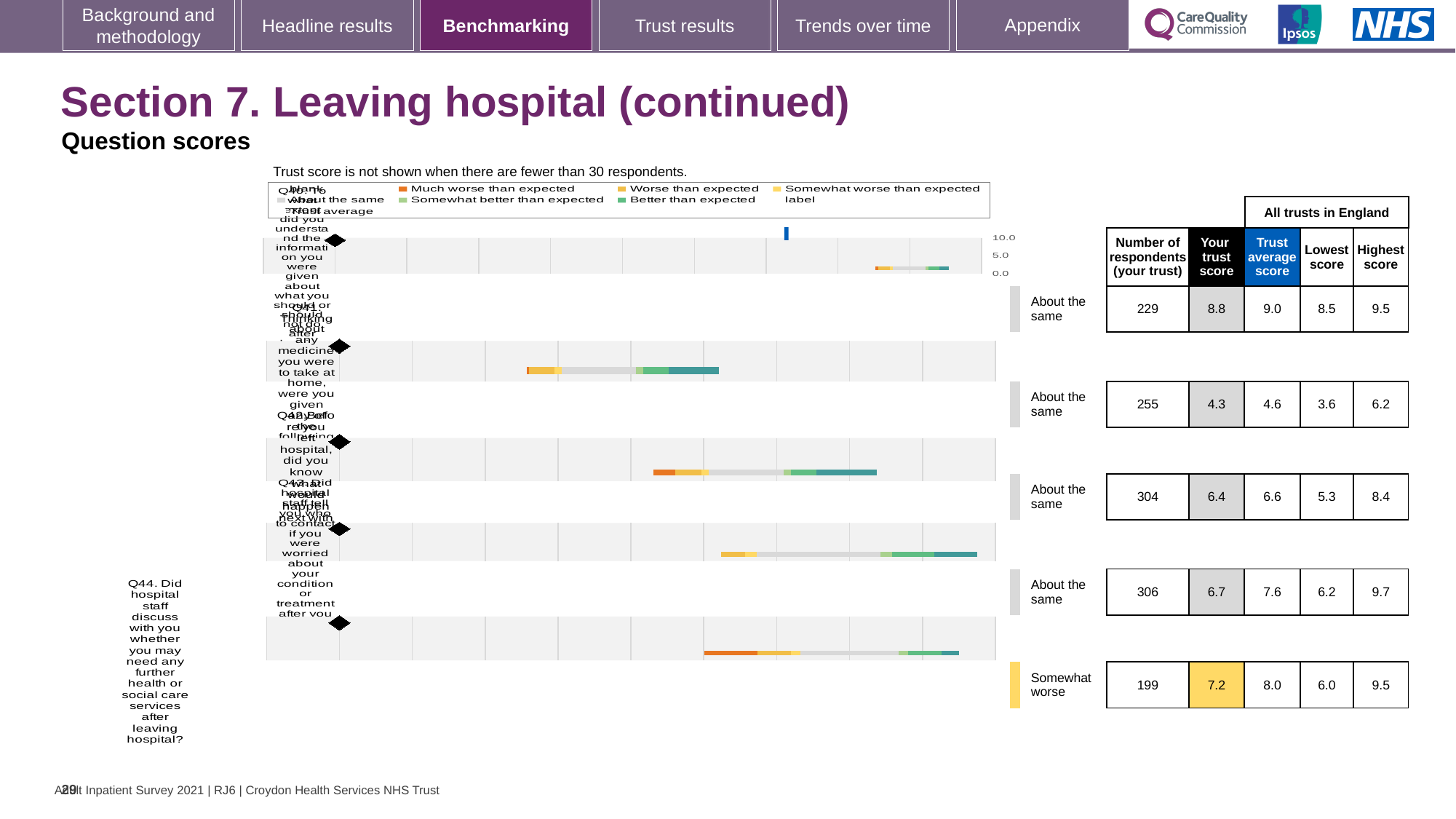
What is the highest score across all trusts in England for Q44? 9.5 What is the lowest 'Your trust score' shown in the table on this slide? 4.3 How many questions are plotted on this slide? 5 How is the trust's result for Q44 categorised compared with expectations? Somewhat worse What is the trust average score for Q44? 8.0 For Q44, which is larger: the trust's own score or the trust average score? Trust average score What kind of chart is used to show the question scores on this slide? bar chart What is the lowest score across all trusts in England for Q44? 6.0 What is the highest 'Your trust score' shown in the table on this slide? 8.8 How many respondents from the trust answered Q44? 199 What is the 'Your trust score' for Q44 (discussing whether you may need further health or social care services after leaving hospital)? 7.2 For Q44, what is the difference between the trust average score and the trust's own score? 0.8